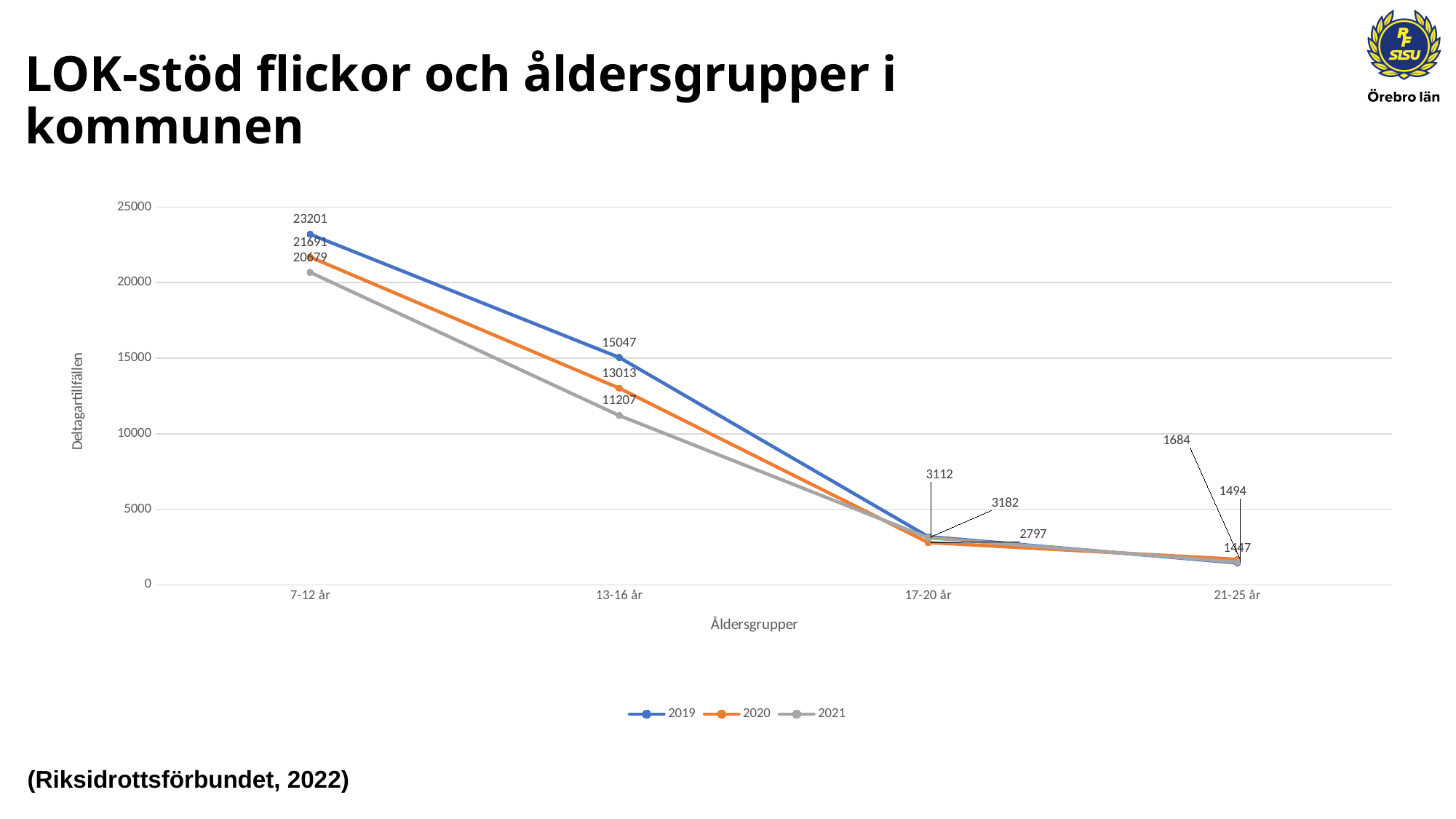
What is the value for 2020 in the 7-12 år age group? 21691 How many age groups are shown on the x axis? 4 Which age group has the highest value for the 2019 series? 7-12 år Which series has the lowest value in the 13-16 år age group? 2021 What is the value for 2019 in the 7-12 år age group? 23201 Do the values for the 2019 series rise or fall from 7-12 år to 21-25 år? fall How many series does the legend list? 3 What is the value for 2021 in the 13-16 år age group? 11207 What is the difference between the 2019 and 2020 values in the 13-16 år age group? 2034 In the 7-12 år age group, which is larger: the 2020 value or the 2021 value? 2020 What kind of chart is shown on the slide? line chart What is the label of the y axis? Deltagartillfällen